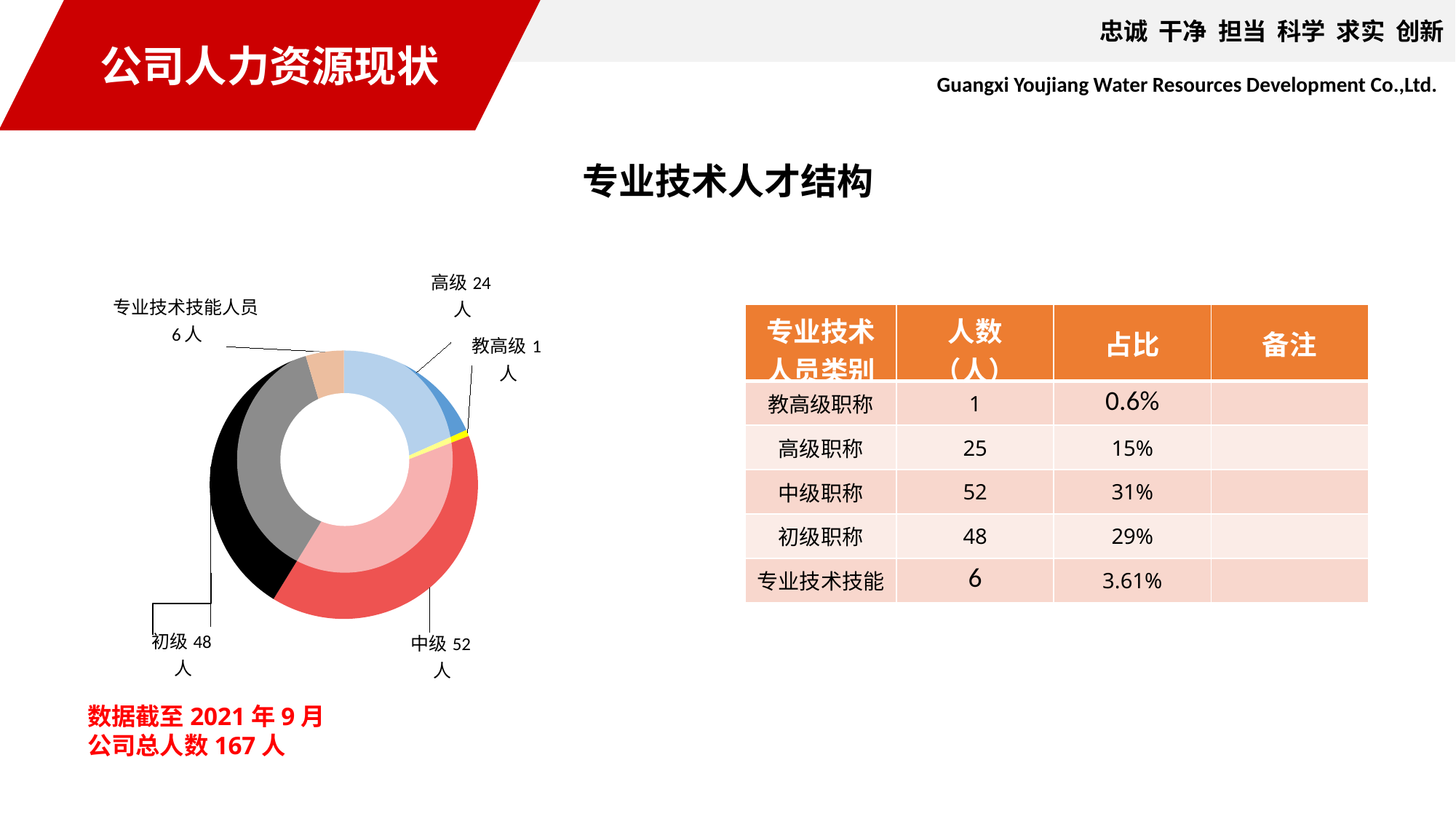
Which category in the doughnut chart has the smallest number of people? 教高级 In the doughnut chart, how many people are labelled for 教高级? 1 人 How many categories are labelled in the doughnut chart? 5 In the doughnut chart, what is the difference between the number of people for 中级 and 初级? 4 In the doughnut chart, how many people are labelled for 中级? 52 人 In the doughnut chart, how many people are labelled for 初级? 48 人 What colour is the 中级 segment in the outer ring of the doughnut chart? Red Which category in the doughnut chart has the largest number of people? 中级 What kind of chart is shown on the left of the slide? Doughnut (pie) chart In the doughnut chart, how many people are labelled for 高级? 24 人 In the doughnut chart, which has more people, 高级 or 初级? 初级 In the doughnut chart, how many people are labelled for 专业技术技能人员? 6 人